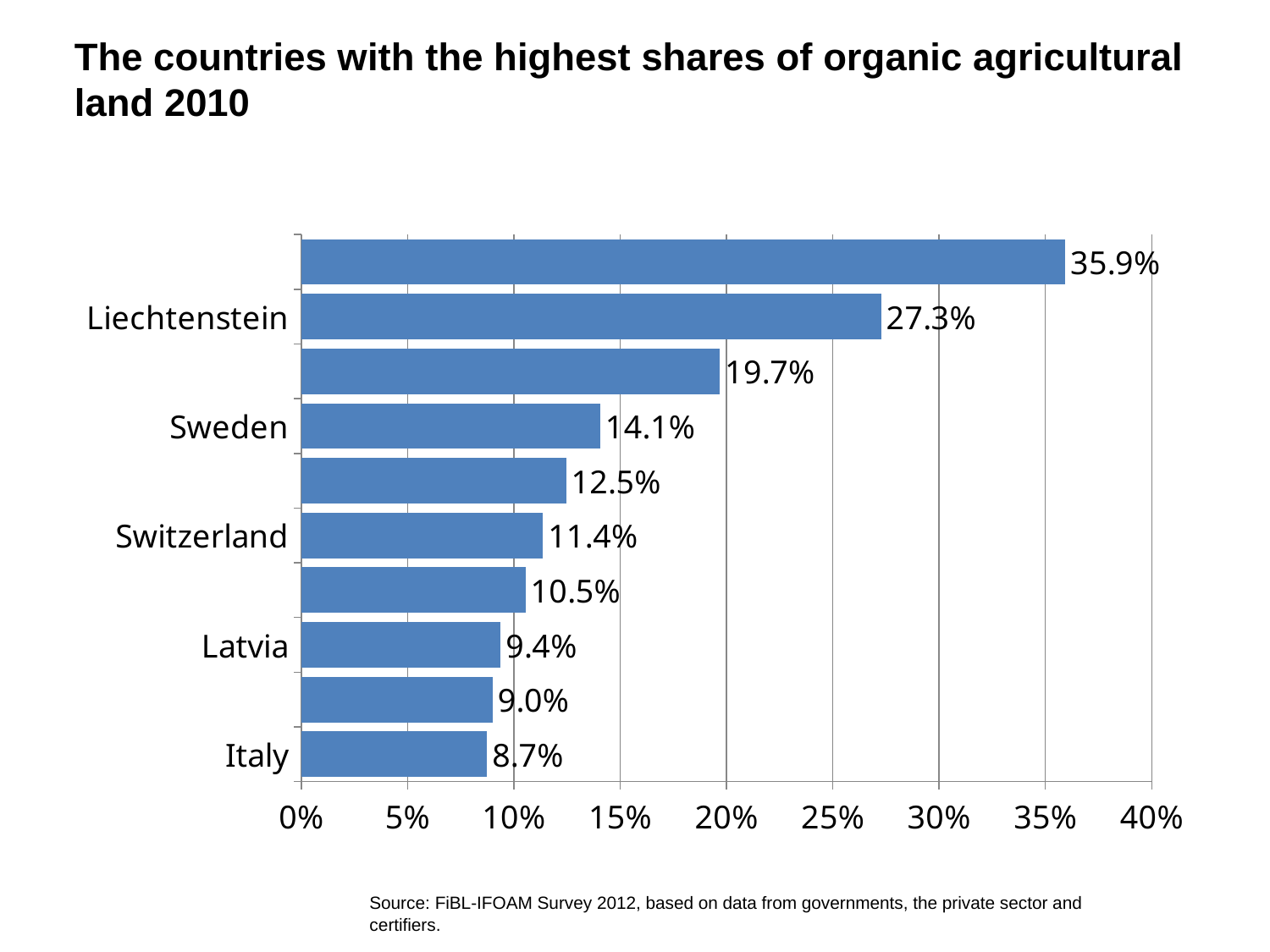
What is the value shown for Latvia? 9.4% How many bars are plotted on the chart? 10 What kind of chart is shown on the slide? Bar chart How many percentage points higher is Liechtenstein's share than Sweden's? 13.2 percentage points What is the value shown for Sweden? 14.1% What is the largest value printed on the chart? 35.9% Which labelled country has the lowest share of organic agricultural land? Italy Is the value for Liechtenstein greater or less than 25%? greater Which has the larger share, Switzerland or Latvia? Switzerland What is the highest value shown on the horizontal axis? 40% What is the share of organic agricultural land for Liechtenstein? 27.3% What is the value shown for Switzerland? 11.4%